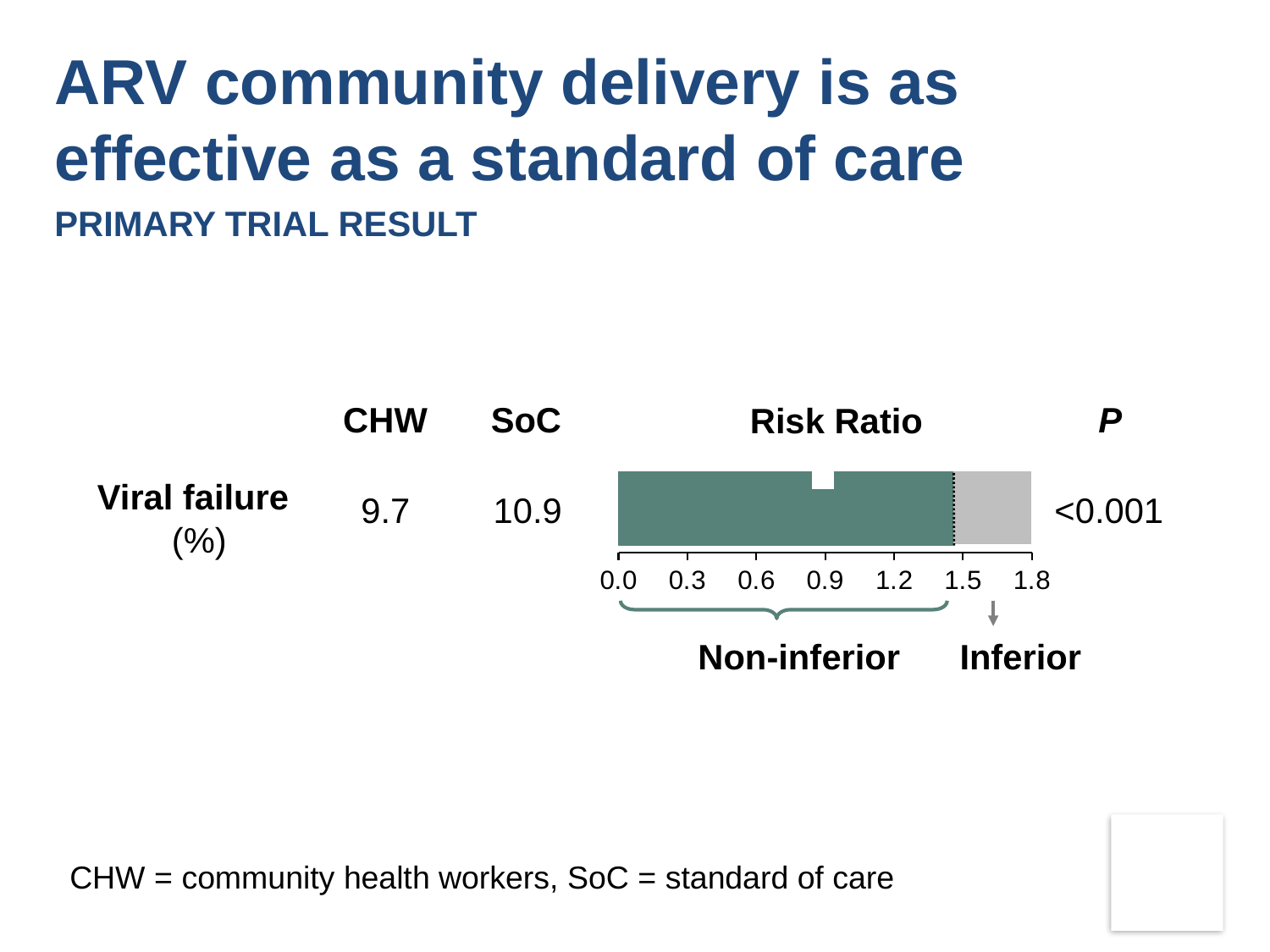
What label is given to the region of the Risk Ratio axis beyond the dotted line? Inferior How many tick labels are shown on the Risk Ratio axis? 7 What is the highest value shown on the Risk Ratio axis? 1.8 Which group has the higher viral failure percentage, CHW or SoC? SoC What is the difference in viral failure percentage between SoC and CHW? 1.2 Is the risk ratio point estimate (the notch in the bar) greater or less than 1.2? less What does the abbreviation CHW stand for on the slide? community health workers What is the P value shown for viral failure? <0.001 What is the viral failure percentage for the CHW group? 9.7 Is the risk ratio point estimate (the notch in the bar) greater or less than 0.6? greater What is the viral failure percentage for the SoC group? 10.9 What kind of chart is used to display the Risk Ratio? bar chart